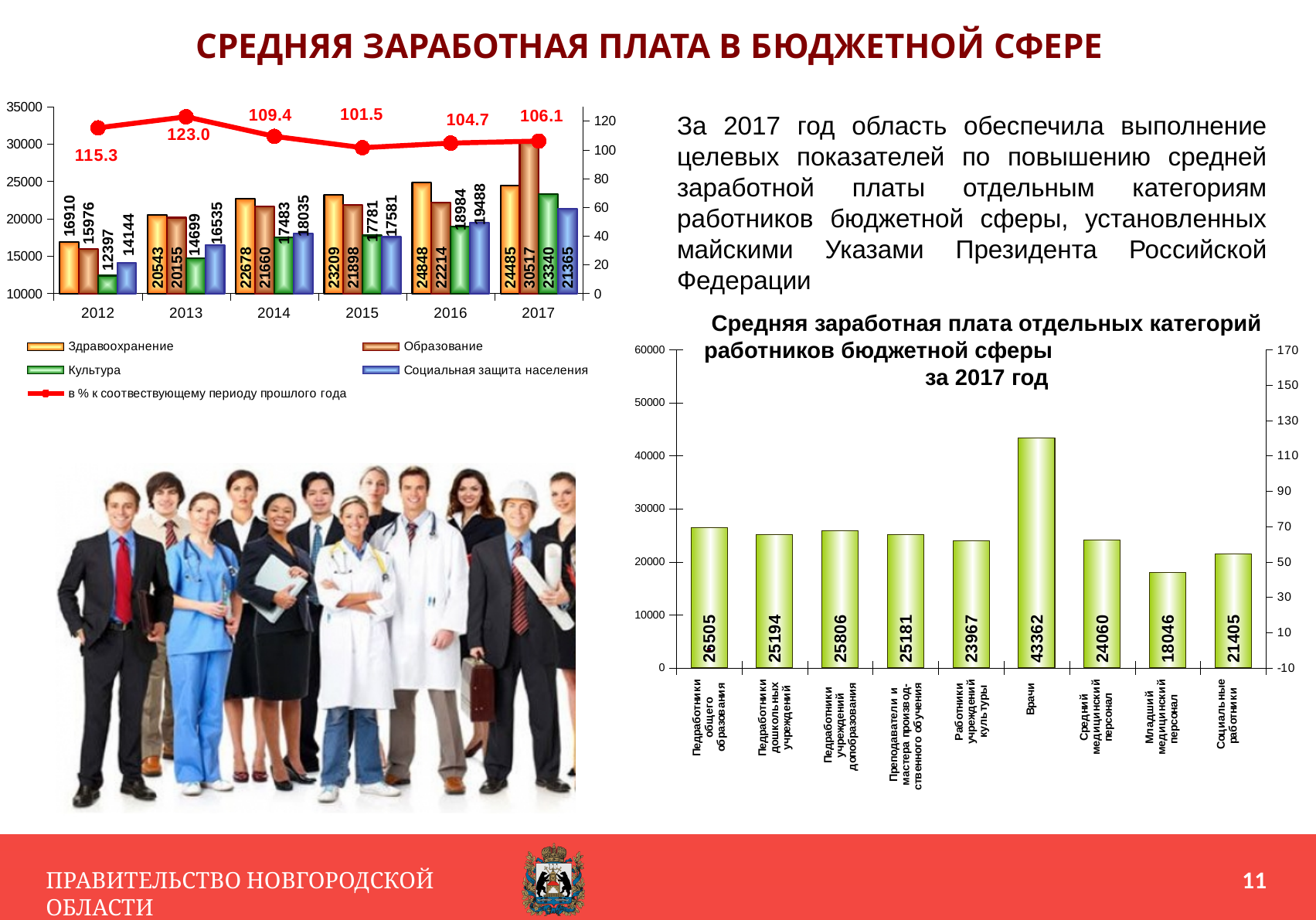
In the chart titled 'Средняя заработная плата отдельных категорий работников бюджетной сферы за 2017 год', what is the value for Врачи? 43362 In the top-left chart, what is the difference between Здравоохранение and Социальная защита населения in 2016? 5360 In the top-left chart, how many series does the legend list? 5 In the top-left chart, what is the value for Образование in 2017? 30517 In the chart titled 'Средняя заработная плата отдельных категорий работников бюджетной сферы за 2017 год', how many categories are shown? 9 In the top-left chart, what is the value for Культура in 2012? 12397 In the chart titled 'Средняя заработная плата отдельных категорий работников бюджетной сферы за 2017 год', what is the difference between Врачи and Младший медицинский персонал? 25316 In the chart titled 'Средняя заработная плата отдельных категорий работников бюджетной сферы за 2017 год', which is larger: Социальные работники or Работники учреждений культуры? Работники учреждений культуры In the chart titled 'Средняя заработная плата отдельных категорий работников бюджетной сферы за 2017 год', which category has the lowest value? Младший медицинский персонал In the chart titled 'Средняя заработная плата отдельных категорий работников бюджетной сферы за 2017 год', which category has the highest value? Врачи In the top-left chart, does the value for Культура rise or fall from 2012 to 2017? rise In the top-left chart, what is the value of the line 'в % к соответствующему периоду прошлого года' for 2013? 123.0